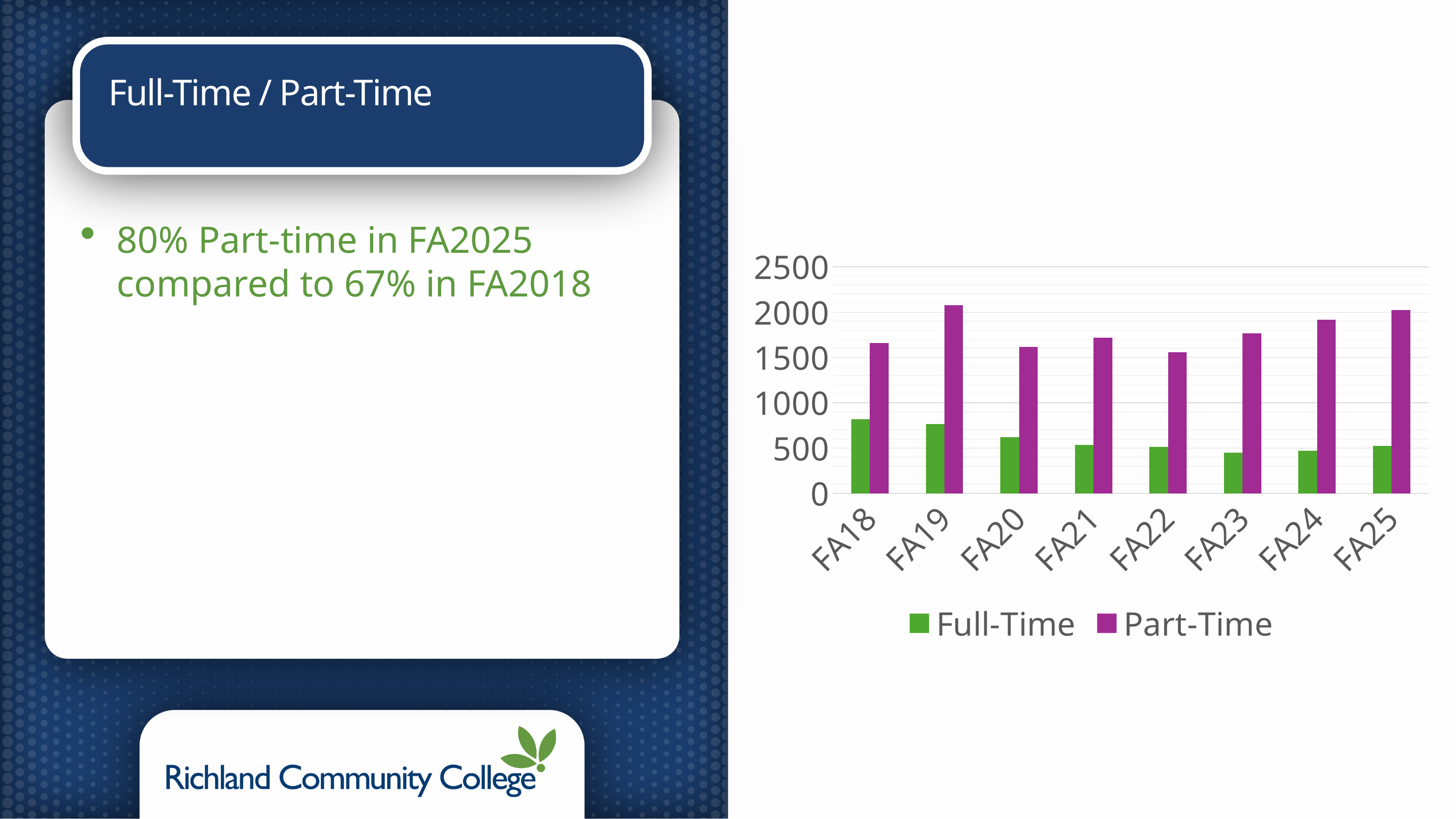
Is the Part-Time value for FA22 greater or less than 1500? greater Is the Part-Time value for FA19 greater or less than 2000? greater Is the Full-Time value for FA23 greater or less than 500? less Does the Full-Time series generally rise or fall from FA18 to FA25? fall How many terms (categories) are shown on the x axis of the chart? 8 What kind of chart is shown on the slide? bar chart What colour are the Part-Time bars in the chart? purple Which is larger: the Full-Time value for FA18 or the Full-Time value for FA25? FA18 Which term has the highest Full-Time value? FA18 How many series does the chart's legend list? 2 In FA18, which is larger: the Full-Time value or the Part-Time value? Part-Time